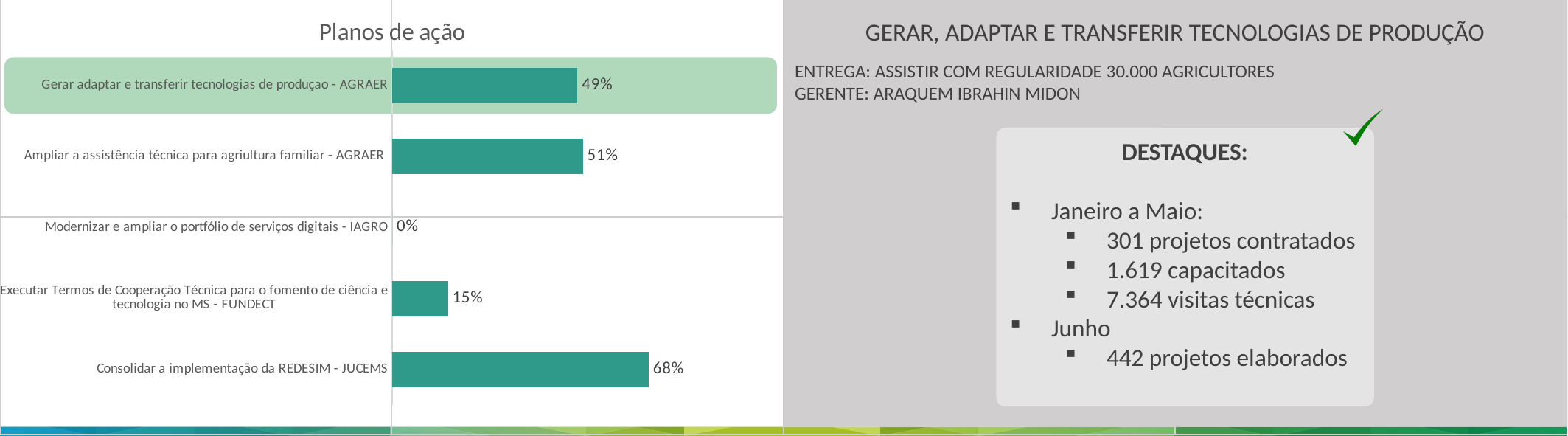
In the 'Planos de ação' chart, which is larger: the value for 'Ampliar a assistência técnica para agriultura familiar - AGRAER' or the value for 'Executar Termos de Cooperação Técnica para o fomento de ciência e tecnologia no MS - FUNDECT'? Ampliar a assistência técnica para agriultura familiar - AGRAER In the 'Planos de ação' chart, what is the difference between the values for 'Ampliar a assistência técnica para agriultura familiar - AGRAER' and 'Gerar adaptar e transferir tecnologias de produçao - AGRAER'? 2% How many categories are shown in the 'Planos de ação' chart? 5 Which category has the highest value in the 'Planos de ação' chart? Consolidar a implementação da REDESIM - JUCEMS What is the title of the chart on the left of the slide? Planos de ação Which category has the lowest value in the 'Planos de ação' chart? Modernizar e ampliar o portfólio de serviços digitais - IAGRO What kind of chart is the 'Planos de ação' chart? Bar chart What is the value for 'Gerar adaptar e transferir tecnologias de produçao - AGRAER' in the 'Planos de ação' chart? 49% What is the value for 'Modernizar e ampliar o portfólio de serviços digitais - IAGRO' in the 'Planos de ação' chart? 0% What is the value for 'Executar Termos de Cooperação Técnica para o fomento de ciência e tecnologia no MS - FUNDECT' in the 'Planos de ação' chart? 15% In the 'Planos de ação' chart, what is the difference between the values for 'Consolidar a implementação da REDESIM - JUCEMS' and 'Ampliar a assistência técnica para agriultura familiar - AGRAER'? 17% What is the value for 'Consolidar a implementação da REDESIM - JUCEMS' in the 'Planos de ação' chart? 68%